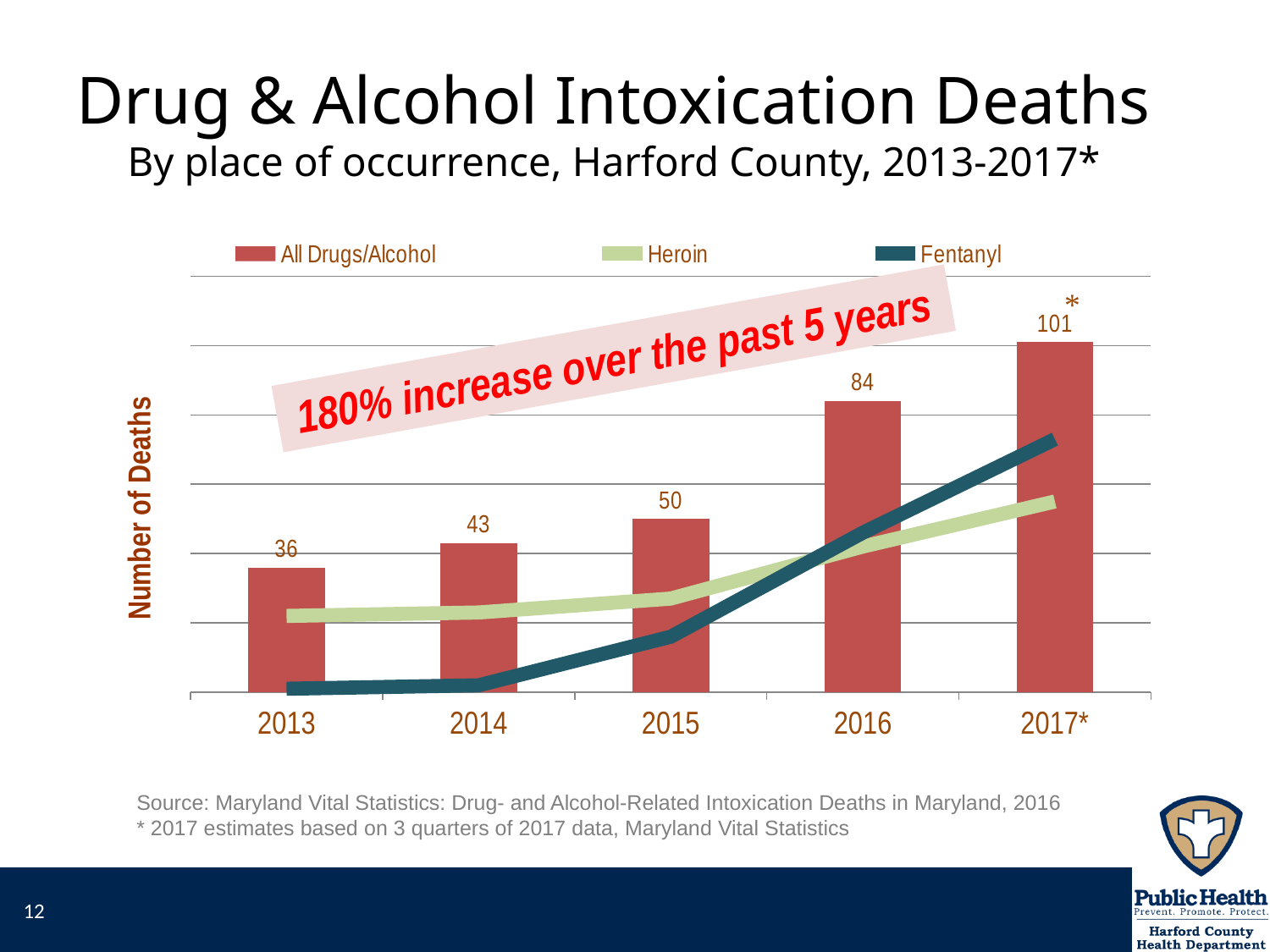
What is the value for All Drugs/Alcohol in 2016? 84 How many series does the legend list? 3 Which year has the highest All Drugs/Alcohol value? 2017* What is the difference between the All Drugs/Alcohol values for 2016 and 2015? 34 What percentage increase over the past 5 years does the annotation on the chart state? 180% What kind of chart is this? Combined bar and line chart How many years are shown on the x axis? 5 Which is larger, the All Drugs/Alcohol value for 2014 or for 2015? 2015 What is the value for All Drugs/Alcohol in 2017*? 101 Which year has the lowest All Drugs/Alcohol value? 2013 Do the All Drugs/Alcohol values rise or fall from 2013 to 2017*? Rise What is the value for All Drugs/Alcohol in 2013? 36